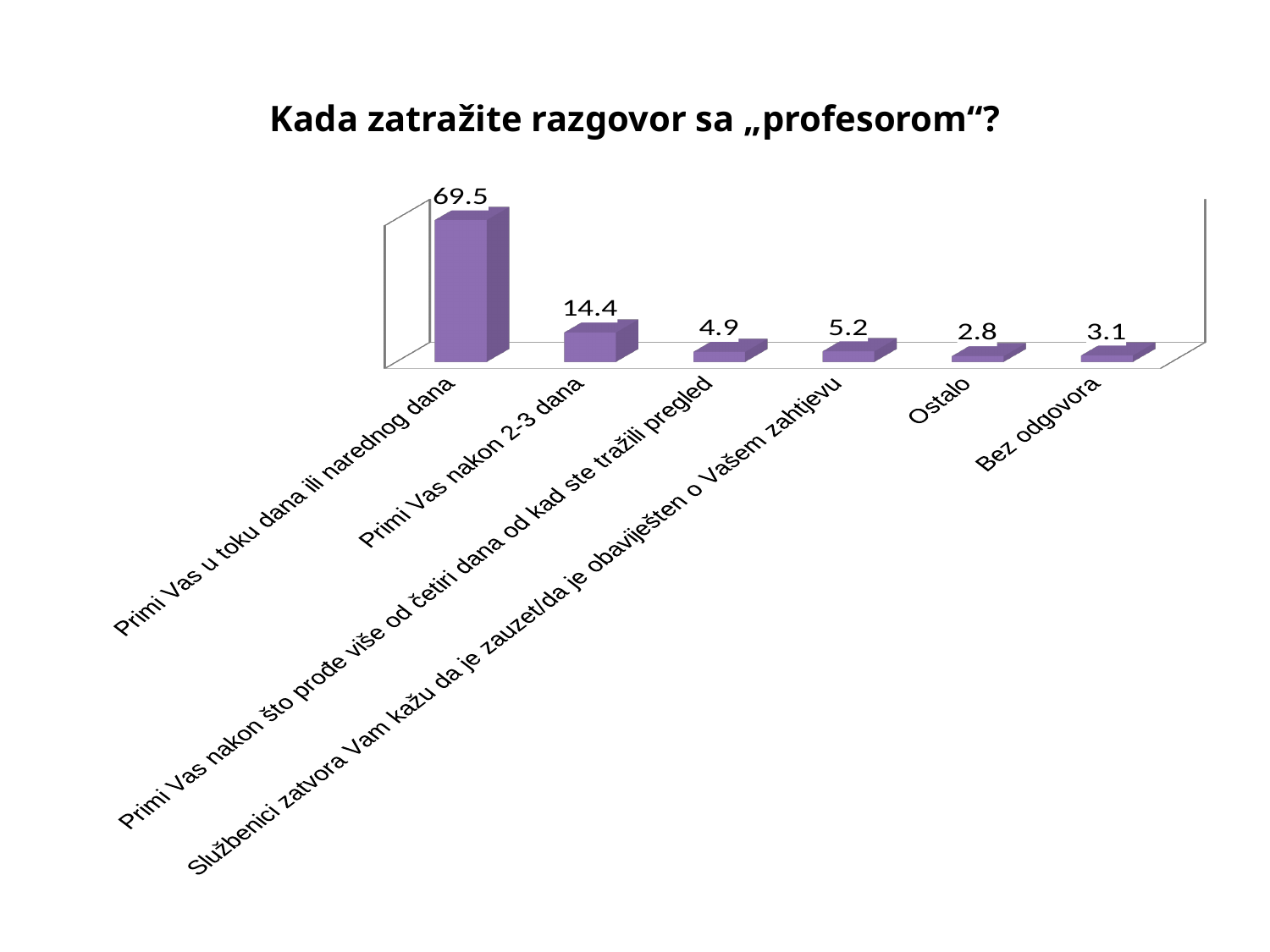
Which category has the lowest value? Ostalo What is the difference between the values for "Primi Vas u toku dana ili narednog dana" and "Primi Vas nakon 2-3 dana"? 55.1 How many categories are shown in the chart? 6 What is the title of the chart? Kada zatražite razgovor sa „profesorom“? What is the value for "Službenici zatvora Vam kažu da je zauzet/da je obaviješten o Vašem zahtjevu"? 5.2 What is the value for "Ostalo"? 2.8 What is the value for "Primi Vas nakon 2-3 dana"? 14.4 What kind of chart is shown on the slide? Bar chart What is the value for "Bez odgovora"? 3.1 Which is larger: the value for "Primi Vas nakon 2-3 dana" or the value for "Bez odgovora"? Primi Vas nakon 2-3 dana Which category has the highest value? Primi Vas u toku dana ili narednog dana What is the value for "Primi Vas u toku dana ili narednog dana"? 69.5